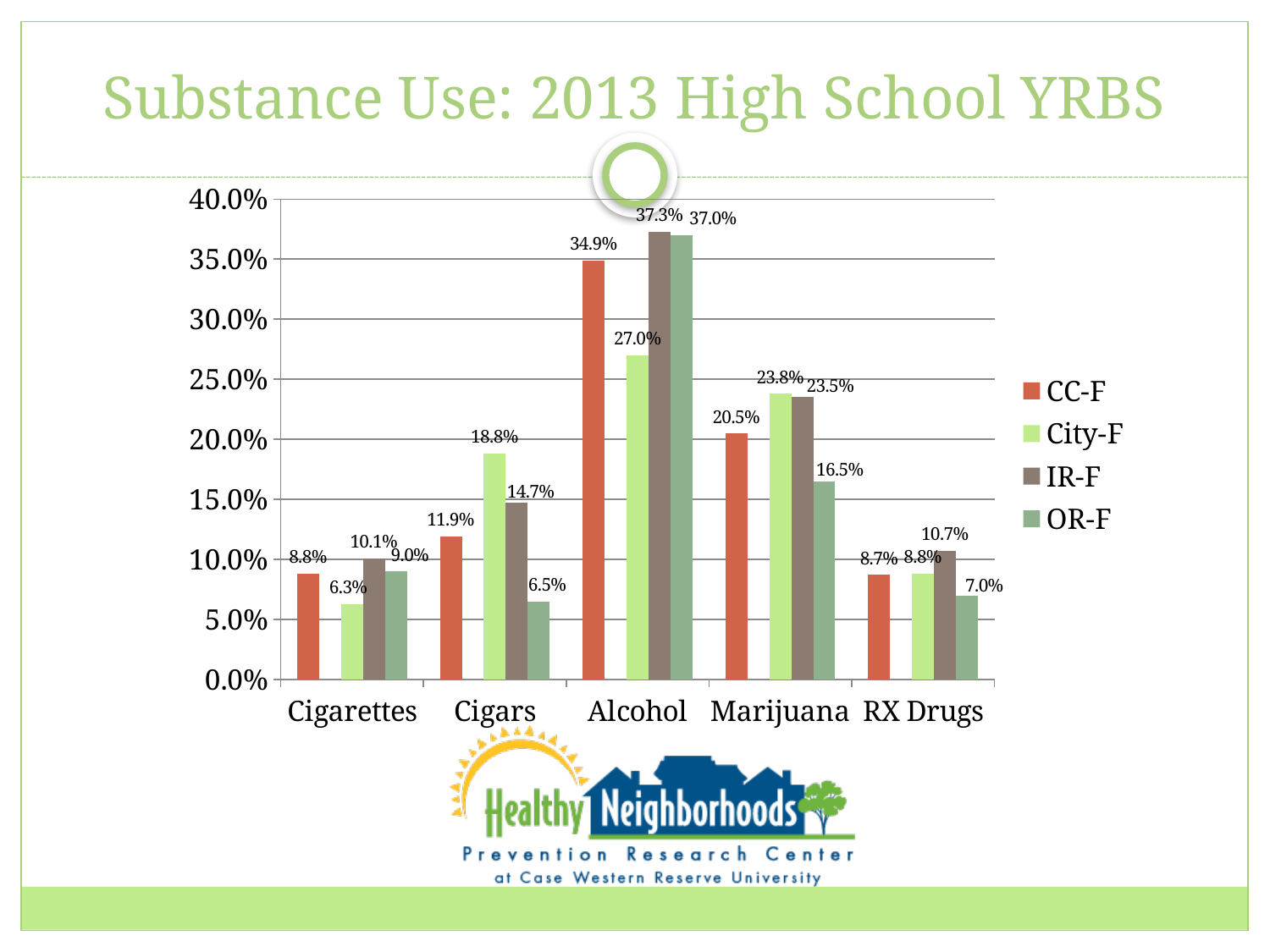
How many categories are shown on the x axis? 5 What is the difference between the IR-F and City-F values in the Alcohol category? 10.3% Which is larger in the Marijuana category, the CC-F value or the City-F value? City-F What is the value for CC-F in the RX Drugs category? 8.7% How many series does the legend list? 4 Is the value for CC-F in the Alcohol category greater or less than 30.0%? greater What is the value for IR-F in the Alcohol category? 37.3% What is the value for City-F in the Cigars category? 18.8% Which series has the lowest value in the Cigars category? OR-F What is the value for OR-F in the Marijuana category? 16.5% What kind of chart is shown on the slide? bar chart Which series has the highest value in the Cigarettes category? IR-F